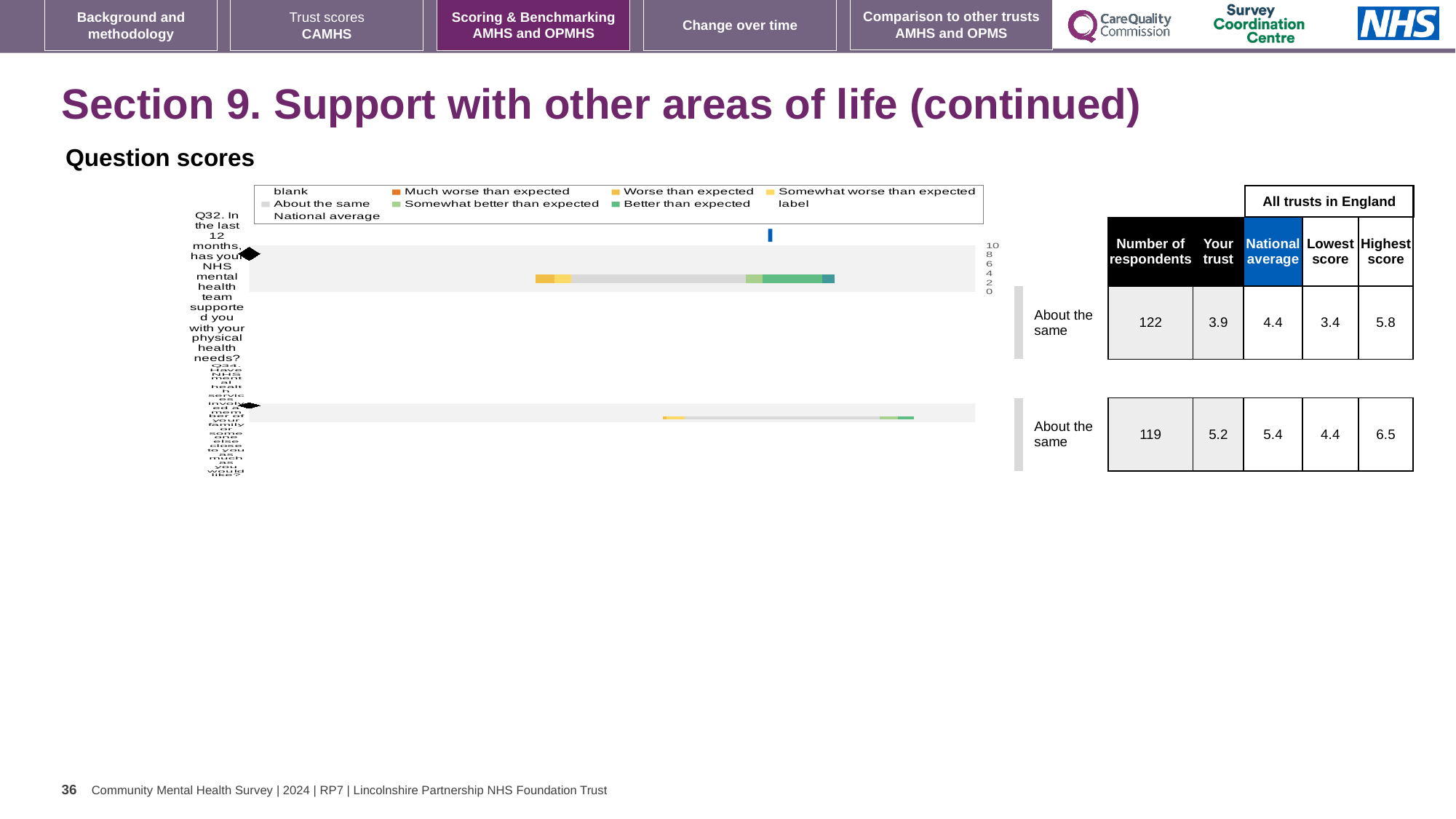
In the table beside the chart, what is the lowest score for Q32? 3.4 In the table beside the chart, what is the 'Your trust' score for Q34? 5.2 In the table beside the chart, what is the number of respondents for Q32? 122 Which legend entry is shown in dark green in the chart's legend? Better than expected In the table beside the chart, what is the difference between the highest and lowest scores for Q32? 2.4 What kind of chart is shown under 'Question scores'? bar chart How many question bars are plotted in the chart? 2 What is the rating label shown beside the Q32 bar? About the same Which question has the larger 'Your trust' score in the table beside the chart, Q32 or Q34? Q34 In the table beside the chart, how much higher is the national average than the 'Your trust' score for Q32? 0.5 In the table beside the chart, what is the highest score for Q34? 6.5 In the table beside the chart, what is the national average for Q32? 4.4